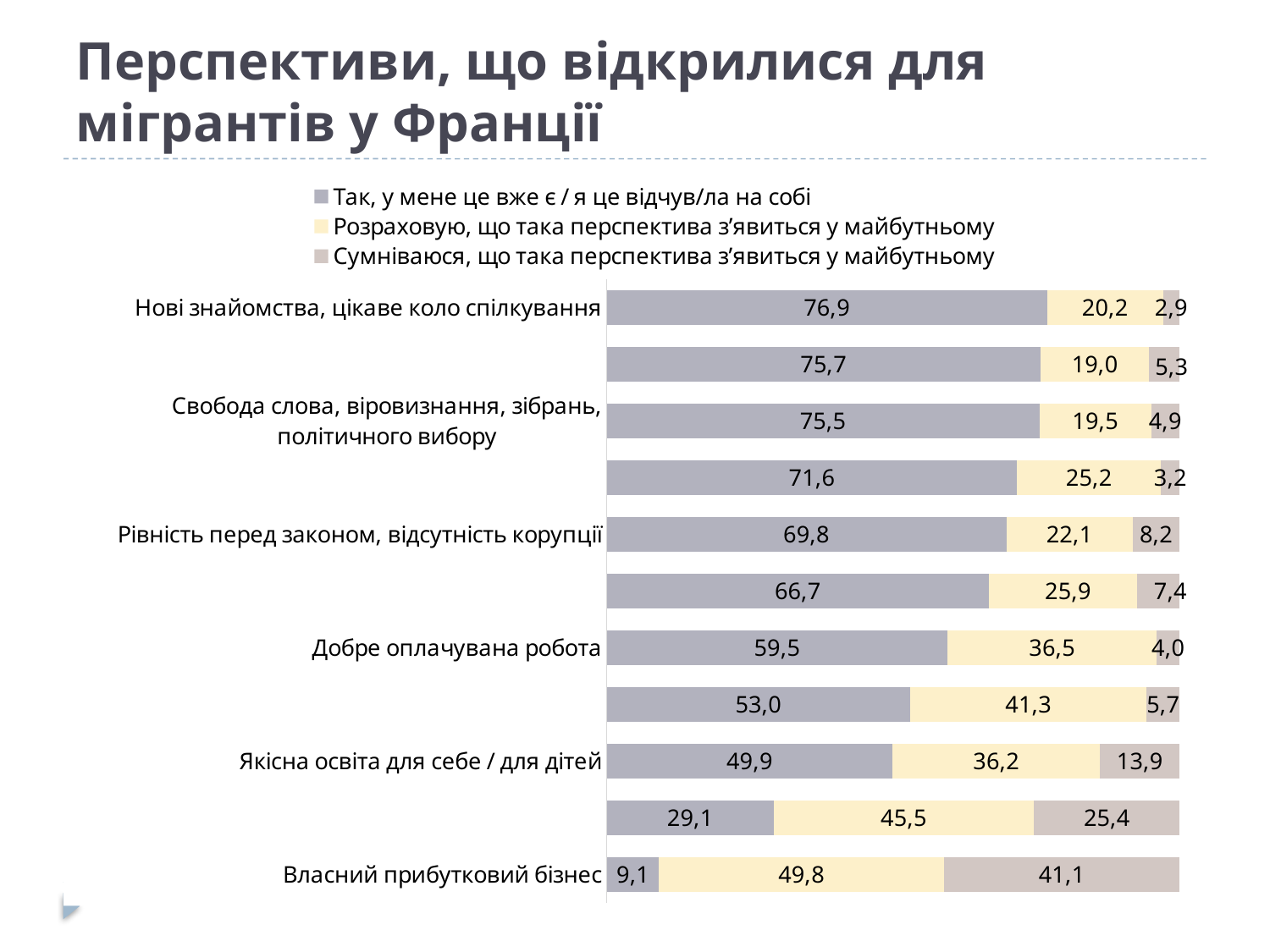
What is the value of the series "Так, у мене це вже є / я це відчув/ла на собі" for "Нові знайомства, цікаве коло спілкування"? 76,9 Among the labelled categories, which has the lowest value for the series "Так, у мене це вже є / я це відчув/ла на собі"? Власний прибутковий бізнес What is the title of the slide? Перспективи, що відкрилися для мігрантів у Франції How many series does the legend list? 3 Among the labelled categories, which has the highest value for the series "Так, у мене це вже є / я це відчув/ла на собі"? Нові знайомства, цікаве коло спілкування What kind of chart is shown on the slide? Stacked bar chart What is the value of the series "Сумніваюся, що така перспектива з’явиться у майбутньому" for "Власний прибутковий бізнес"? 41,1 What is the difference between the "Так, у мене це вже є / я це відчув/ла на собі" values for "Нові знайомства, цікаве коло спілкування" and "Рівність перед законом, відсутність корупції"? 7,1 What is the value of the series "Розраховую, що така перспектива з’явиться у майбутньому" for "Добре оплачувана робота"? 36,5 What is the value of the series "Сумніваюся, що така перспектива з’явиться у майбутньому" for "Якісна освіта для себе / для дітей"? 13,9 Which is larger: the "Розраховую, що така перспектива з’явиться у майбутньому" value for "Власний прибутковий бізнес" or for "Якісна освіта для себе / для дітей"? Власний прибутковий бізнес How many bars are plotted in the chart? 11